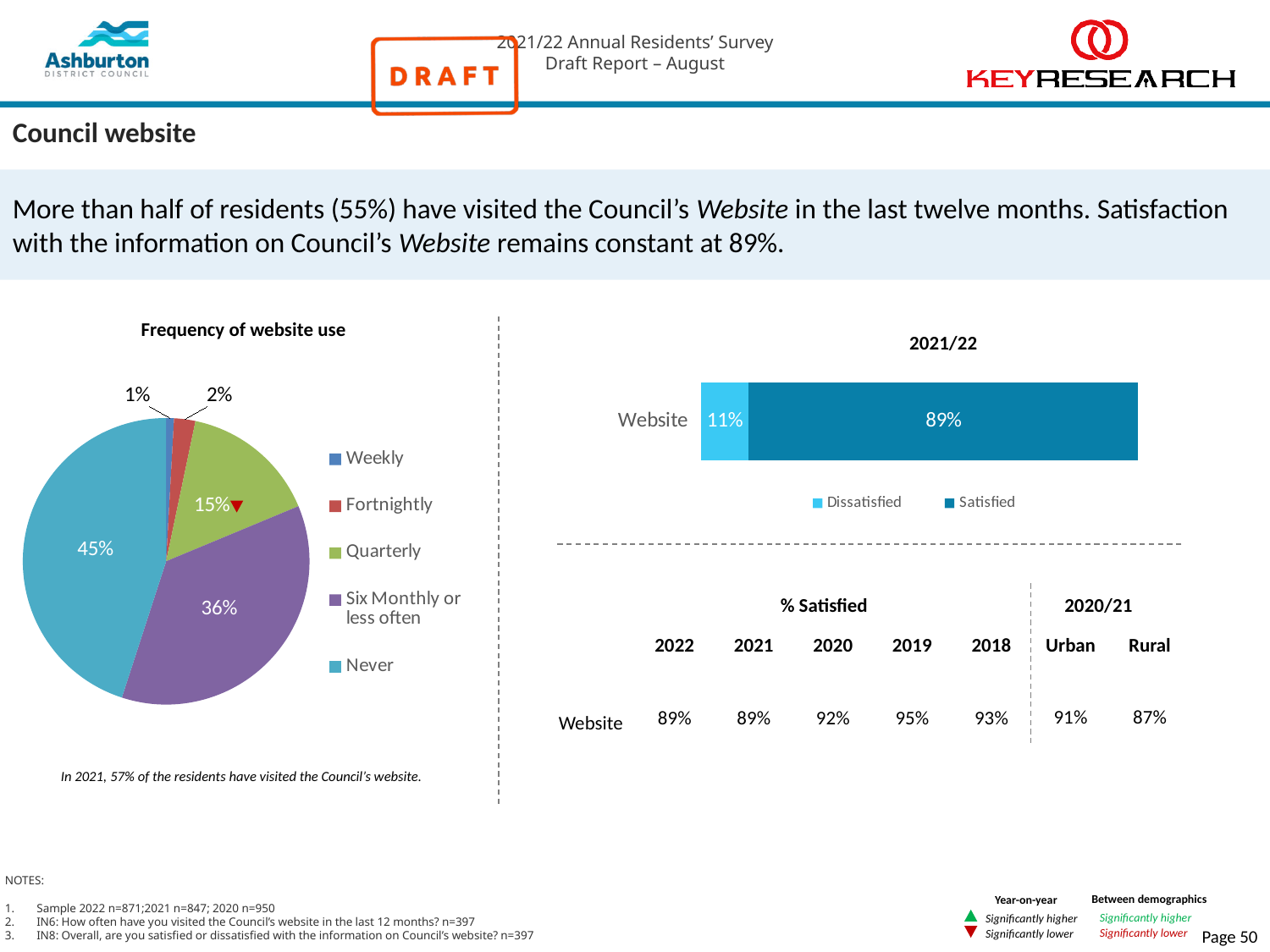
In the 'Frequency of website use' pie chart, what share of residents answered 'Never'? 45% What kind of chart is the 'Frequency of website use' chart? Pie chart In the 'Frequency of website use' pie chart, what share of residents answered 'Six Monthly or less often'? 36% In the '2021/22' chart on the right, what percentage of residents are dissatisfied with the Website? 11% How many series does the legend of the '2021/22' chart on the right list? 2 In the 'Frequency of website use' pie chart, which category has the largest share? Never In the 'Frequency of website use' pie chart, what share of residents answered 'Quarterly'? 15% In the 'Frequency of website use' pie chart, which is larger: 'Fortnightly' or 'Weekly'? Fortnightly In the 'Frequency of website use' pie chart, how many categories does the legend list? 5 In the '2021/22' chart on the right, what percentage of residents are satisfied with the Website? 89% In the 'Frequency of website use' pie chart, which category has the smallest share? Weekly In the 'Frequency of website use' pie chart, what is the difference between the 'Never' and 'Six Monthly or less often' shares? 9%